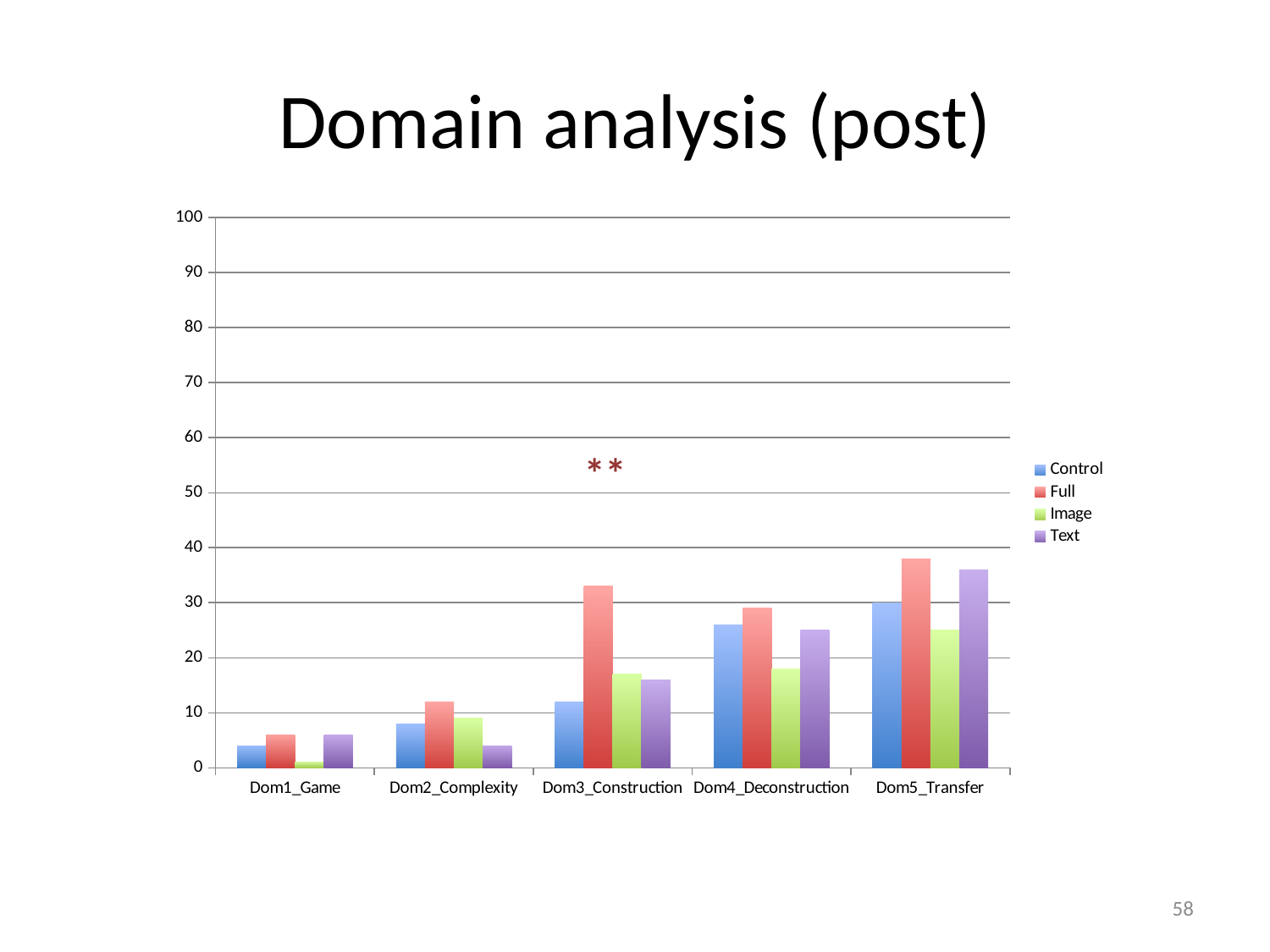
What is the title of the chart? Domain analysis (post) Which category has the highest Full value? Dom5_Transfer Do the Control values rise or fall from Dom1_Game to Dom5_Transfer? rise How many categories are shown on the x axis? 5 For Dom3_Construction, which is larger: the Full value or the Control value? Full Is the Text value for Dom5_Transfer greater or less than 30? greater Is the Image value for Dom4_Deconstruction greater or less than 20? less How many series does the legend list? 4 Is the Image value for Dom1_Game greater or less than 10? less Which category has the lowest Image value? Dom1_Game What kind of chart is shown on the slide? bar chart